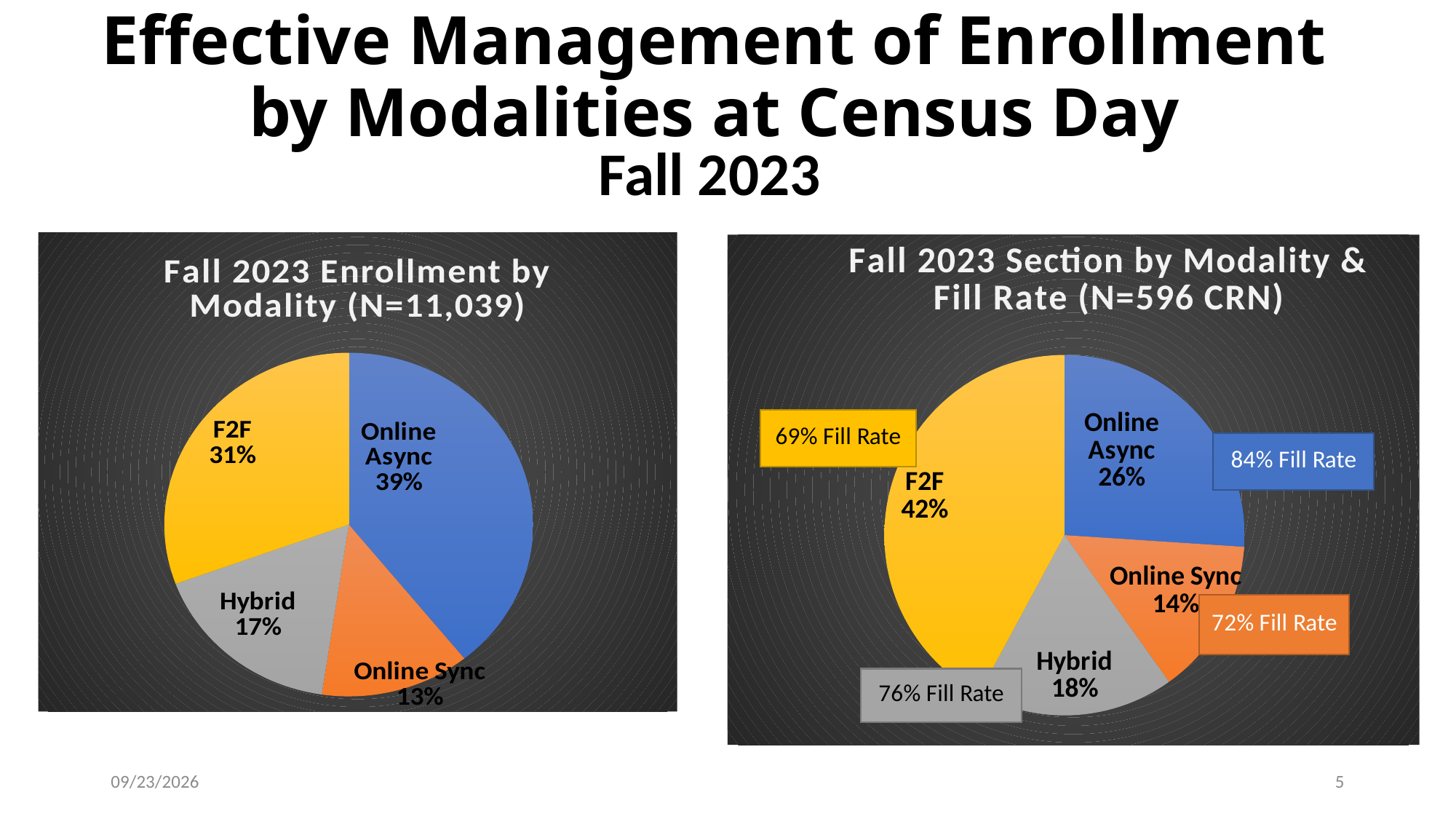
In the 'Fall 2023 Enrollment by Modality' pie chart, what is the difference in percentage points between Online Async and F2F? 8 In the 'Fall 2023 Enrollment by Modality' pie chart, which modality has the largest share? Online Async In the 'Fall 2023 Section by Modality & Fill Rate' pie chart, which modality has the largest share of sections? F2F In the 'Fall 2023 Section by Modality & Fill Rate' chart, which is larger, the Hybrid share or the Online Sync share? Hybrid What kind of chart is the 'Fall 2023 Section by Modality & Fill Rate' chart? Pie chart In the 'Fall 2023 Enrollment by Modality' pie chart, what share of enrollment is Online Async? 39% In the 'Fall 2023 Enrollment by Modality' pie chart, what share of enrollment is Hybrid? 17% In the 'Fall 2023 Enrollment by Modality' pie chart, how many slices are there? 4 In the 'Fall 2023 Section by Modality & Fill Rate' chart, what is the fill rate for Online Async? 84% Fill Rate In the 'Fall 2023 Enrollment by Modality' pie chart, which modality has the smallest share? Online Sync What is the N value shown in the title of the left pie chart? N=11,039 In the 'Fall 2023 Section by Modality & Fill Rate' pie chart, what share of sections is F2F? 42%